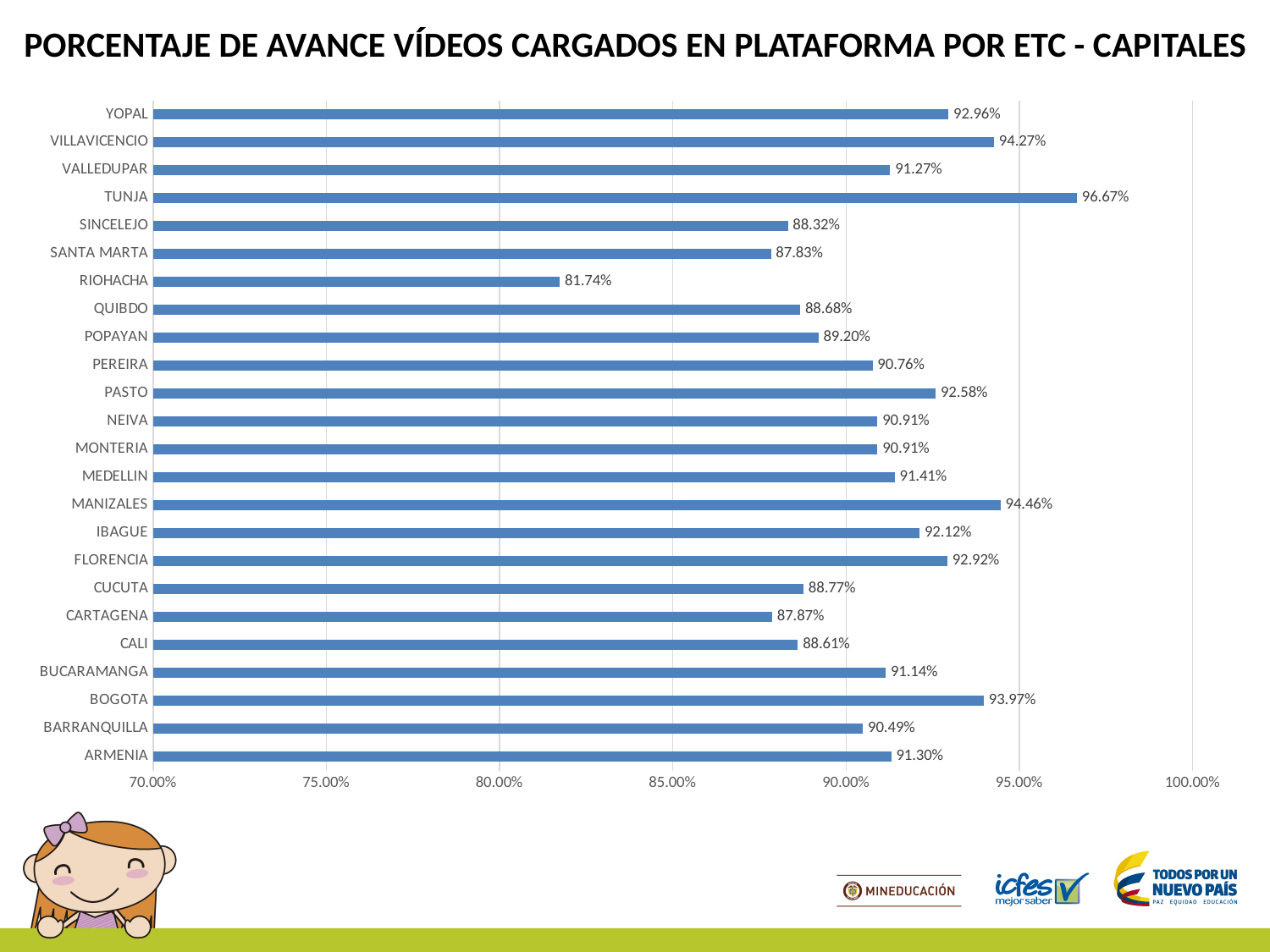
What is the difference between the values for TUNJA and RIOHACHA? 14.93 percentage points What is the value for BARRANQUILLA? 90.49% What is the difference between the values for BOGOTA and CALI? 5.36 percentage points Which capital has the highest percentage? TUNJA What kind of chart is shown on the slide? Bar chart What is the value for BOGOTA? 93.97% Which capital has the lowest percentage? RIOHACHA What is the value for TUNJA? 96.67% What is the value for RIOHACHA? 81.74% Is the value for RIOHACHA greater or less than 85.00%? less How many capitals are shown in the chart? 24 Which is larger, the value for YOPAL or the value for SANTA MARTA? YOPAL